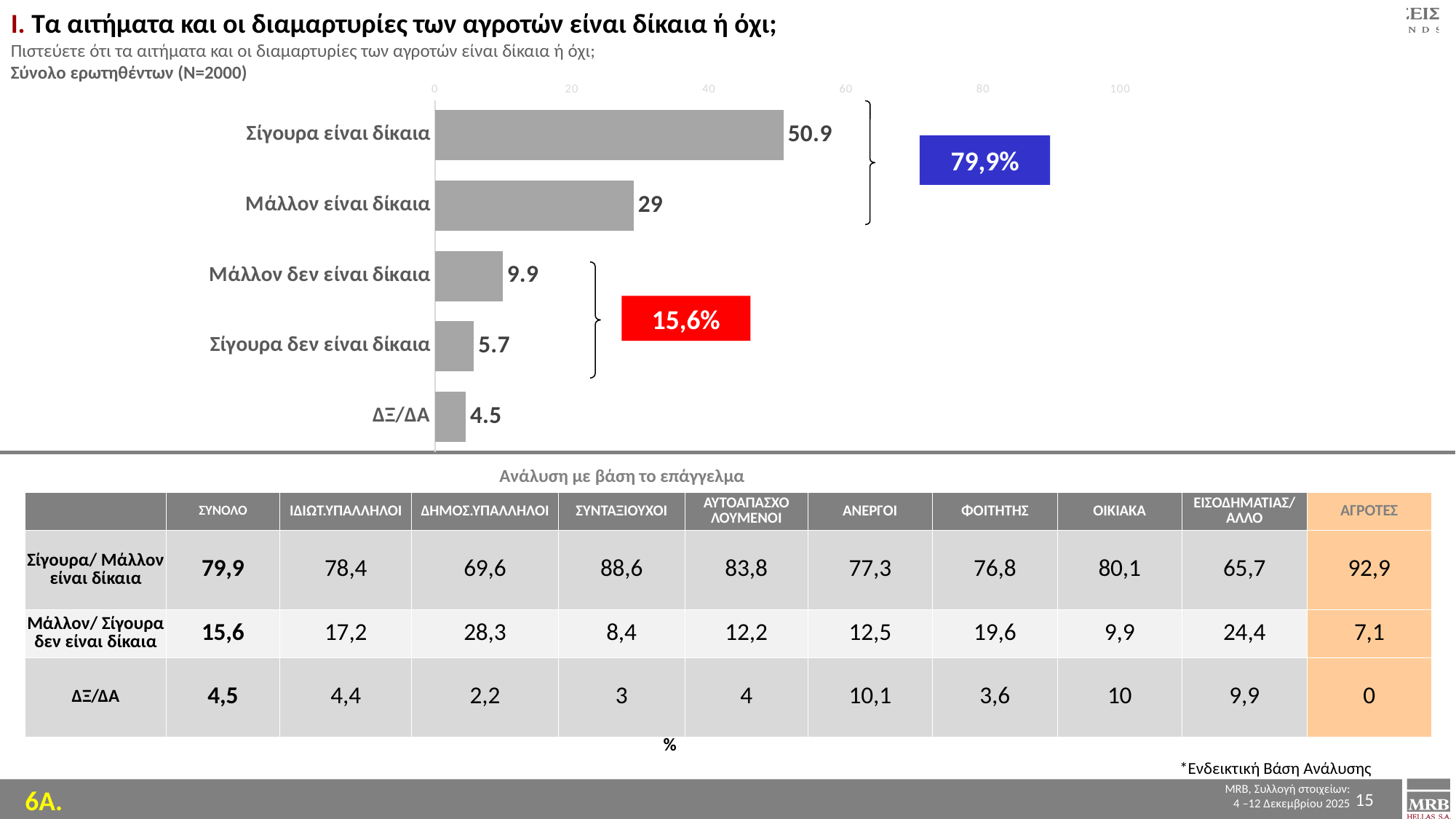
What kind of chart is shown on the slide? Bar chart What is the value for "ΔΞ/ΔΑ"? 4.5 How many categories are shown in the bar chart? 5 What is the value for "Σίγουρα είναι δίκαια"? 50.9 What is the value for "Μάλλον δεν είναι δίκαια"? 9.9 Which category has the lowest value in the bar chart? ΔΞ/ΔΑ Which category has the highest value in the bar chart? Σίγουρα είναι δίκαια What is the value for "Σίγουρα δεν είναι δίκαια"? 5.7 Which is larger, the value for "Μάλλον δεν είναι δίκαια" or "Σίγουρα δεν είναι δίκαια"? Μάλλον δεν είναι δίκαια What is the difference between the values for "Σίγουρα είναι δίκαια" and "Μάλλον είναι δίκαια"? 21.9 What combined percentage is shown in the blue box next to the two "είναι δίκαια" bars? 79,9% What is the value for "Μάλλον είναι δίκαια"? 29